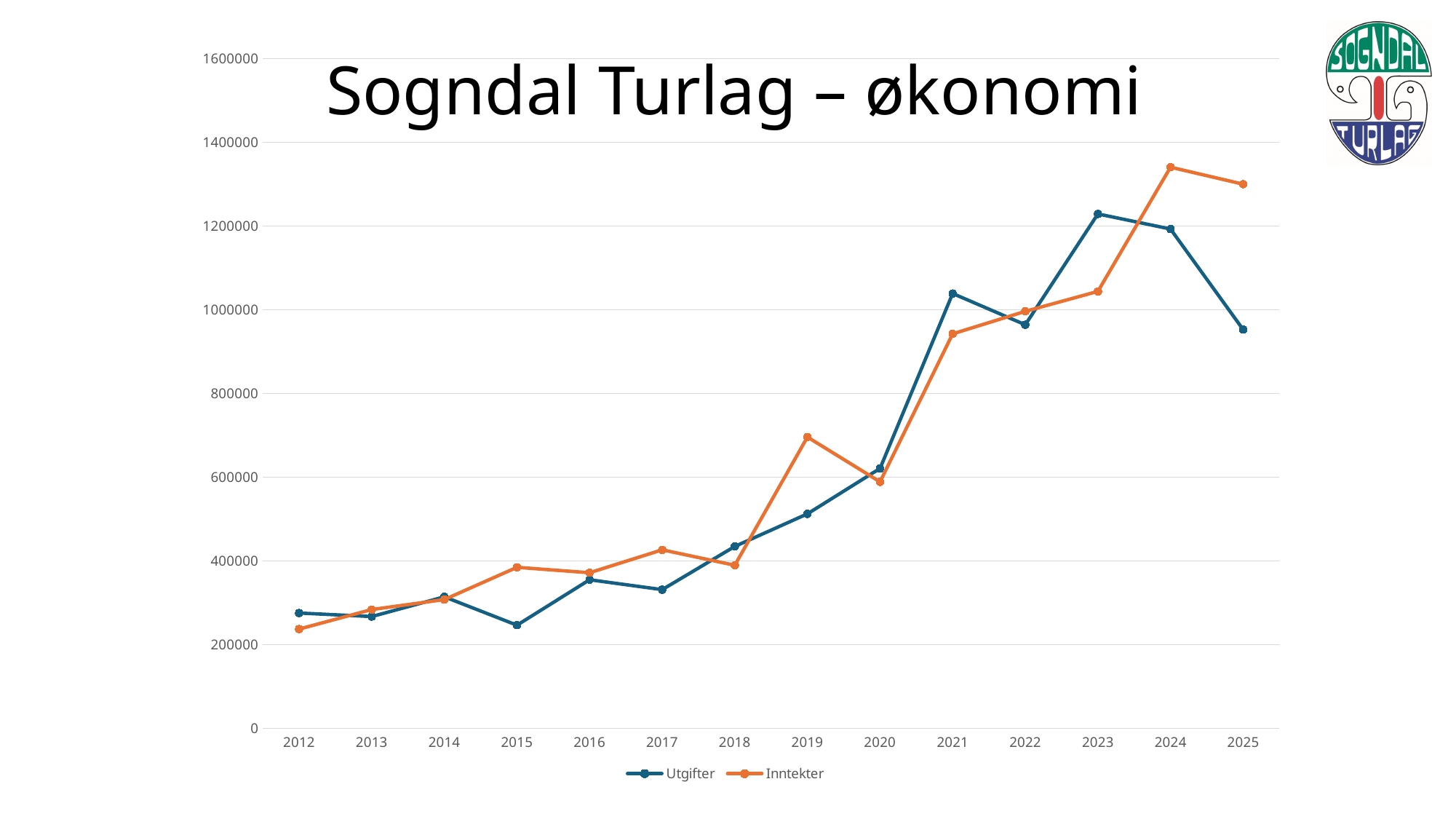
In which year is Inntekter at its lowest? 2012 In which year is Utgifter at its lowest? 2015 Is the value for Inntekter in 2024 greater or less than 1200000? greater In which year is Inntekter at its highest? 2024 What is the title of the chart? Sogndal Turlag – økonomi What kind of chart is shown on the slide? Line chart Does Inntekter generally rise or fall from 2012 to 2025? Rise How many series does the legend list? 2 How many years are plotted along the x axis? 14 In 2024, which is larger, Utgifter or Inntekter? Inntekter Which colour is used for the Inntekter series? Orange Is the value for Utgifter in 2025 greater or less than 1000000? less